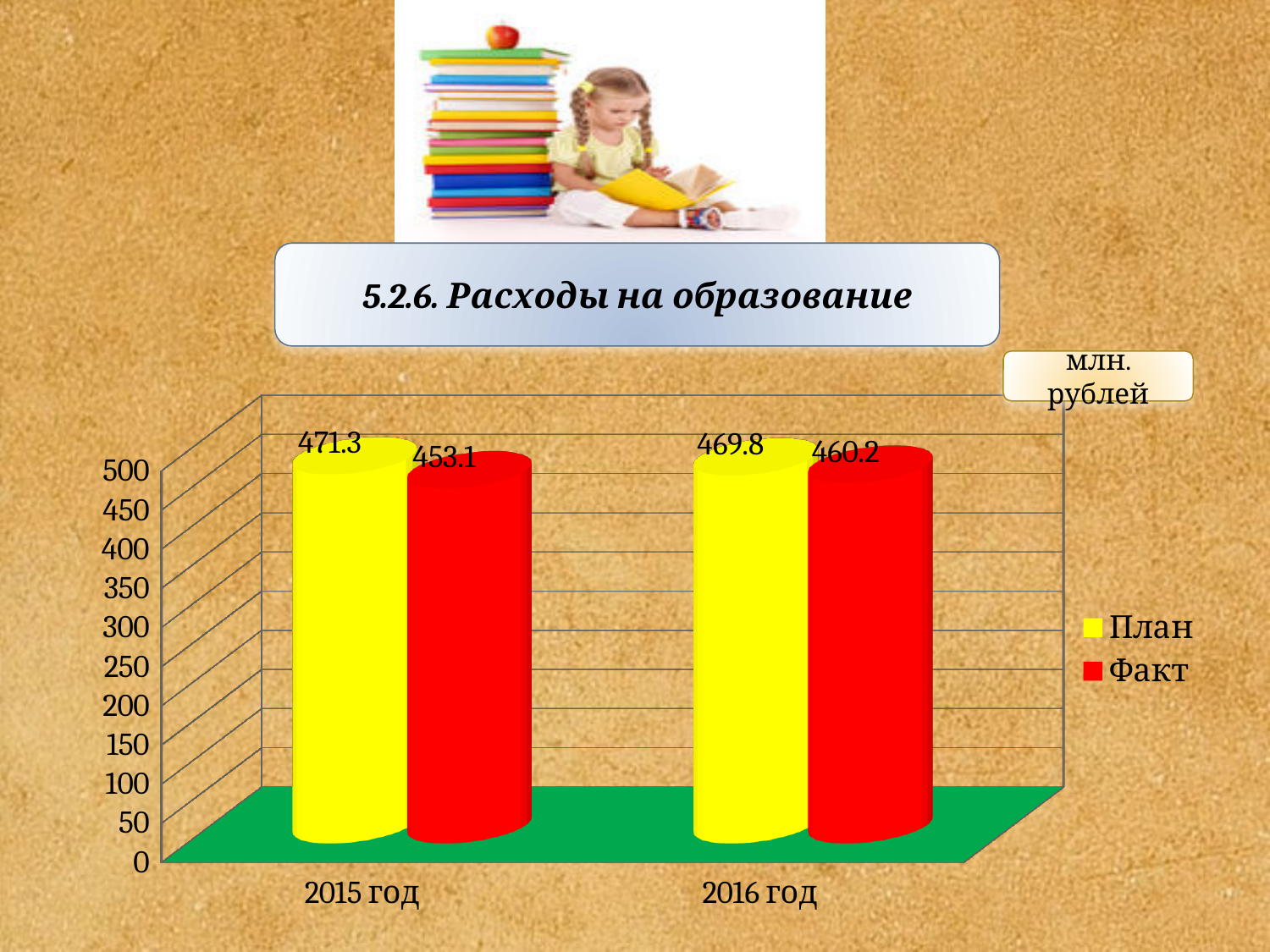
What is the difference between План and Факт for 2015 год? 18.2 What unit is shown for the chart values? млн. рублей What is the Факт value for 2016 год? 460.2 How many series does the legend list? 2 What is the План value for 2015 год? 471.3 Which year has the higher Факт value? 2016 год What is the Факт value for 2015 год? 453.1 What is the План value for 2016 год? 469.8 What kind of chart is shown on the slide? Bar chart Which year has the lower План value? 2016 год Which is larger for 2016 год, План or Факт? План What is the difference between План and Факт for 2016 год? 9.6